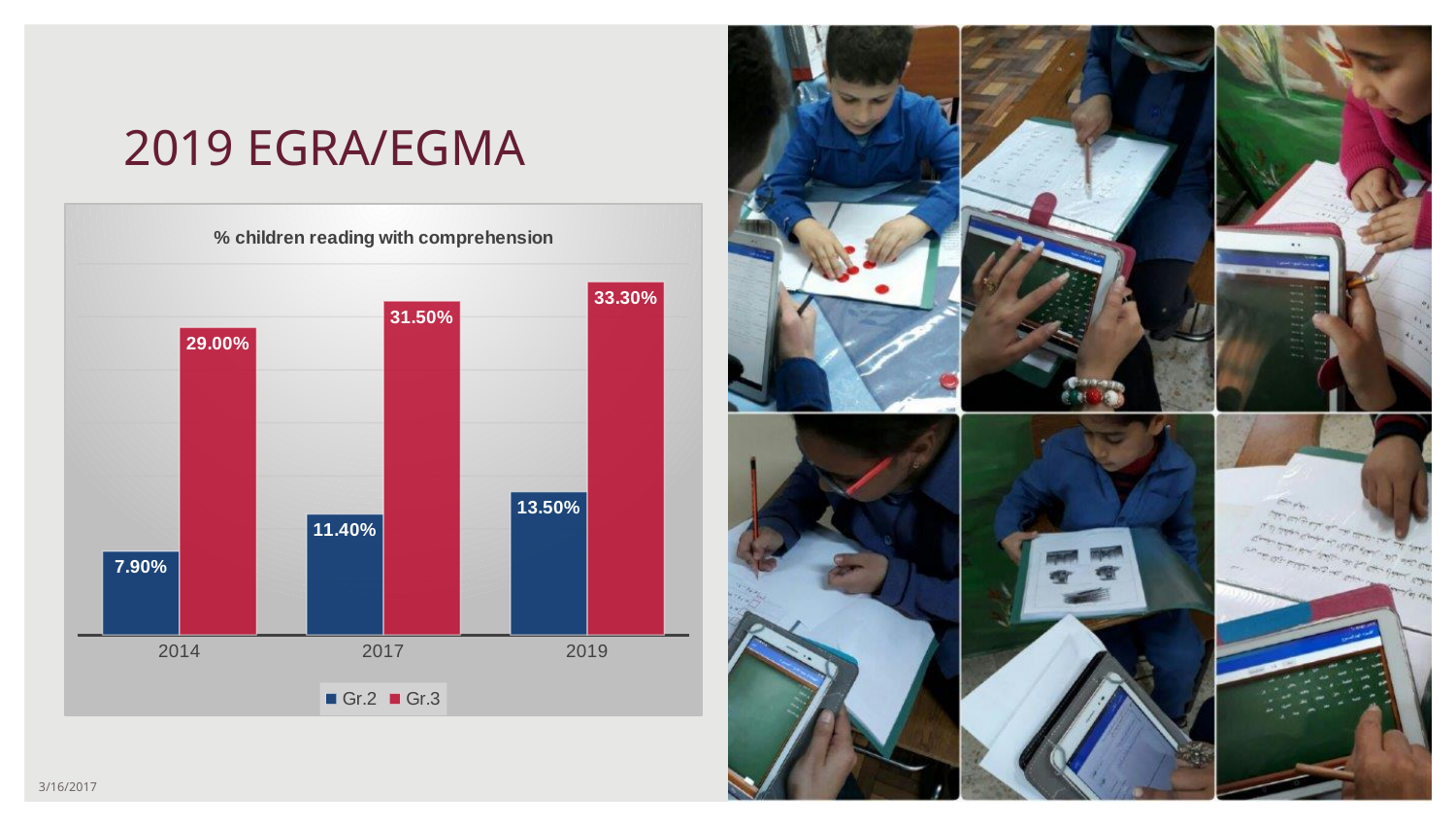
Which is larger in 2017, the Gr.2 value or the Gr.3 value? Gr.3 In which year is the Gr.2 value lowest? 2014 How many series does the legend list? 2 What is the value for Gr.2 in 2019? 13.50% How many years are shown on the x axis? 3 What is the value for Gr.2 in 2014? 7.90% What is the value for Gr.3 in 2019? 33.30% What is the difference between the Gr.3 and Gr.2 values in 2014? 21.10% In which year is the Gr.3 value highest? 2019 What is the value for Gr.3 in 2017? 31.50% What kind of chart is shown on the slide? Bar chart Do the Gr.2 values rise or fall from 2014 to 2019? Rise